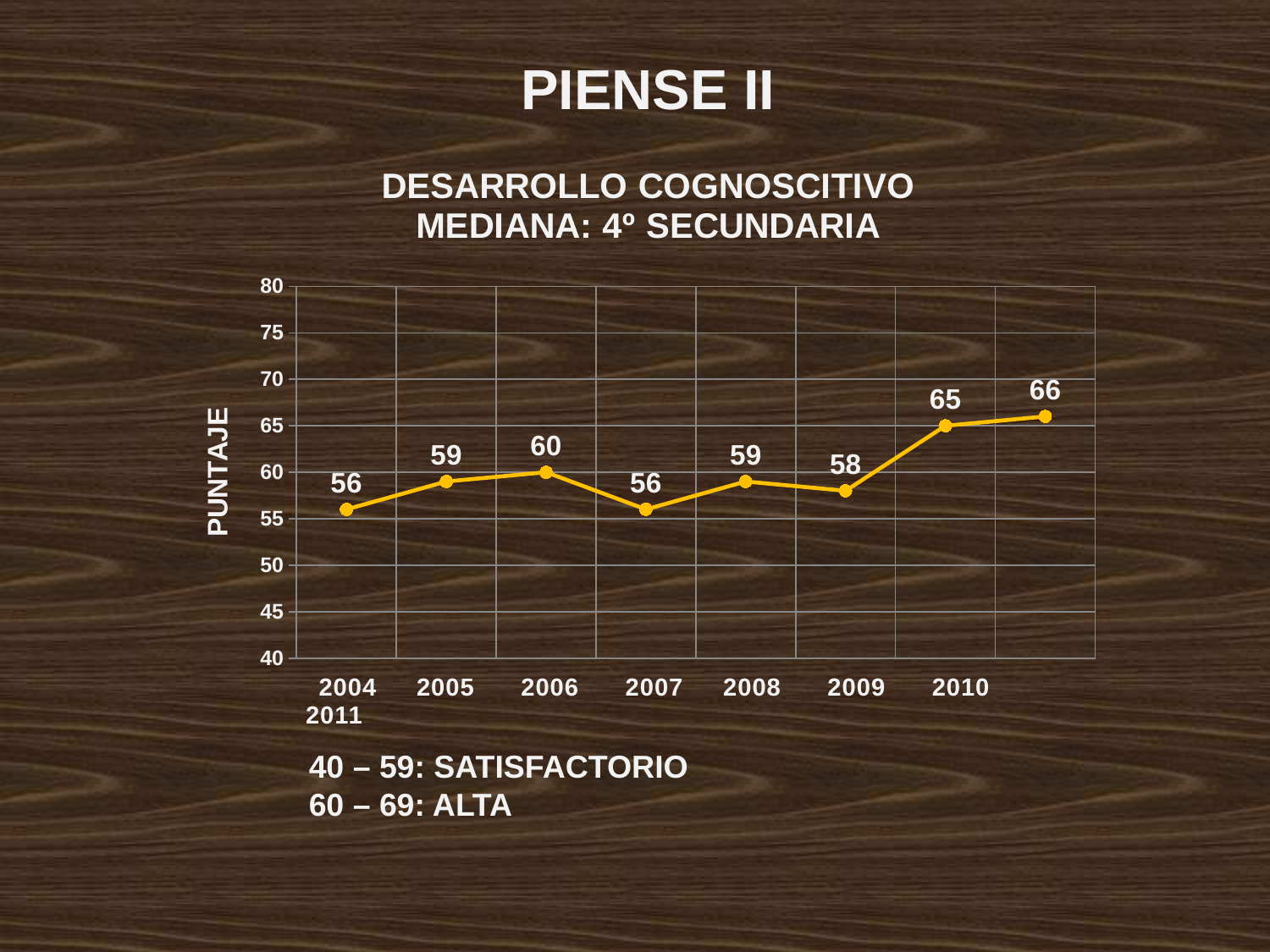
What is the difference between the values for 2010 and 2009? 7 What is the lowest value plotted on the chart? 56 What is the value for 2004? 56 What is the label on the vertical axis of the chart? PUNTAJE What is the difference between the values for 2011 and 2004? 10 What is the value for 2006? 60 Which year has the highest value? 2011 What is the value for 2009? 58 What is the value for 2010? 65 Which is larger, the value for 2006 or the value for 2007? 2006 How many data points are plotted on the chart? 8 What kind of chart is shown on the slide? line chart